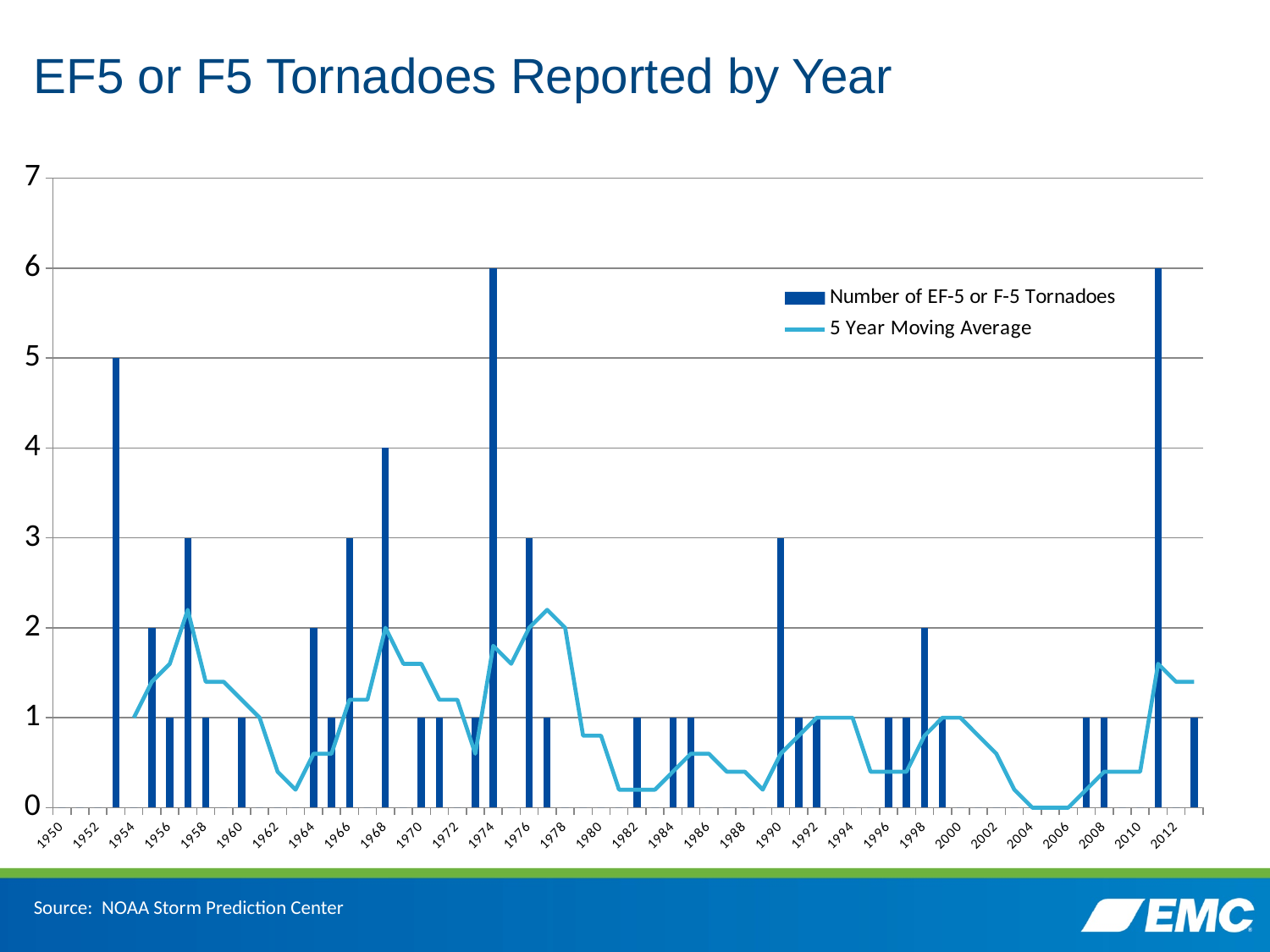
Is the 5 Year Moving Average value at 2004 greater or less than 1? less How many EF-5 or F-5 tornadoes were reported in 1974? 6 What kind of chart is used to show the Number of EF-5 or F-5 Tornadoes series? Bar chart Is the 5 Year Moving Average value at 1962 greater or less than 1? less How many EF-5 or F-5 tornadoes were reported in 1998? 2 Which year had more EF-5 or F-5 tornadoes, 1968 or 1990? 1968 What is the highest number of EF-5 or F-5 tornadoes reported in a single year on the chart? 6 How many EF-5 or F-5 tornadoes were reported in 1990? 3 How many EF-5 or F-5 tornadoes were reported in 1968? 4 What is the title of the chart? EF5 or F5 Tornadoes Reported by Year What is the difference between the number of EF-5 or F-5 tornadoes in 1974 and in 1968? 2 How many series does the legend list? 2